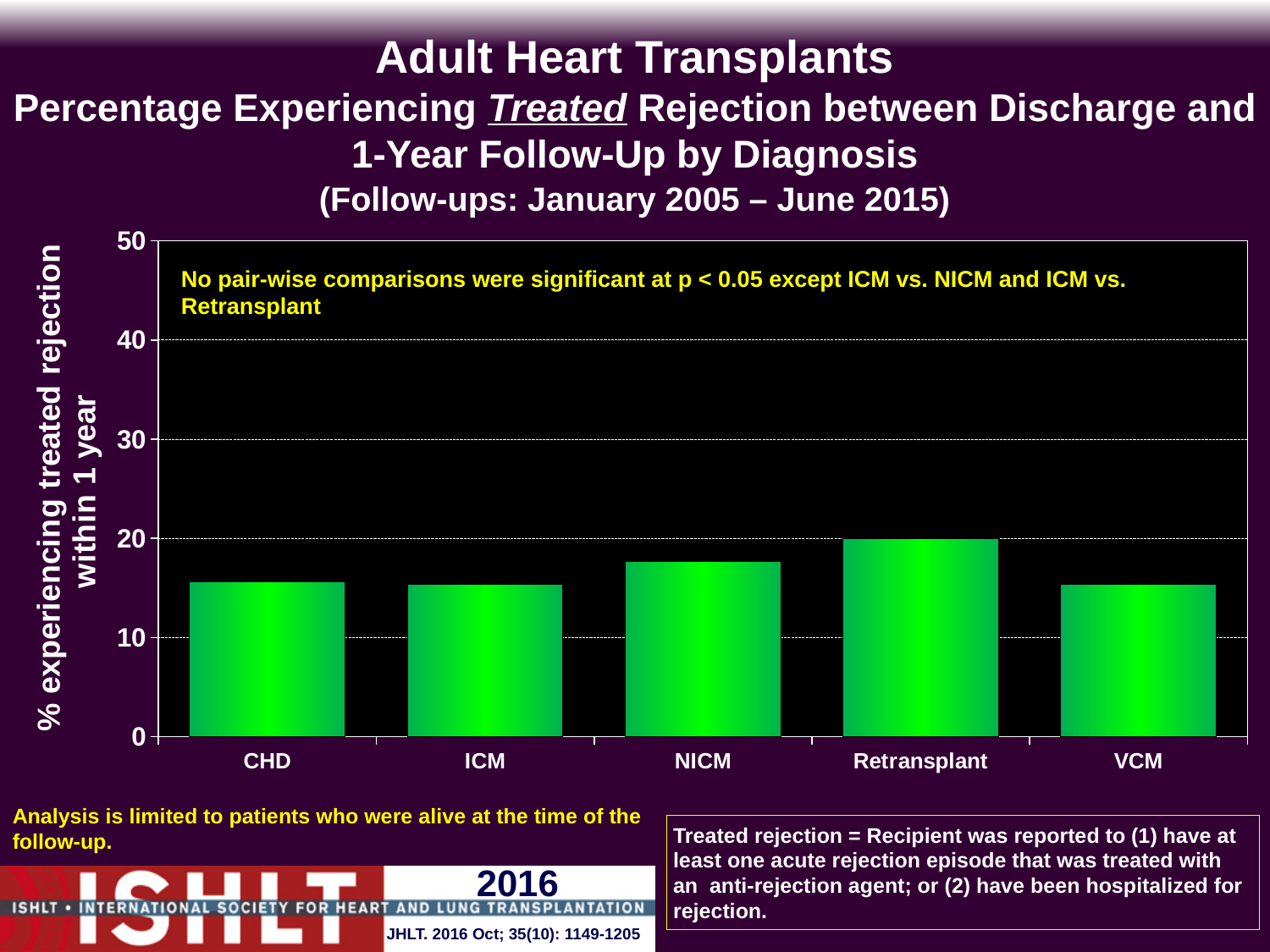
Which is larger, the value for Retransplant or the value for CHD? Retransplant Is the value for ICM greater or less than 30? less Which diagnosis category has the highest percentage experiencing treated rejection within 1 year? Retransplant What follow-up period is given in the chart title? January 2005 – June 2015 What kind of chart is shown on the slide? bar chart Is the value for CHD greater or less than 20? less Which is larger, the value for NICM or the value for ICM? NICM What is the label of the y axis? % experiencing treated rejection within 1 year Is the value for VCM greater or less than 20? less Which is larger, the value for Retransplant or the value for VCM? Retransplant How many diagnosis categories are shown on the x axis? 5